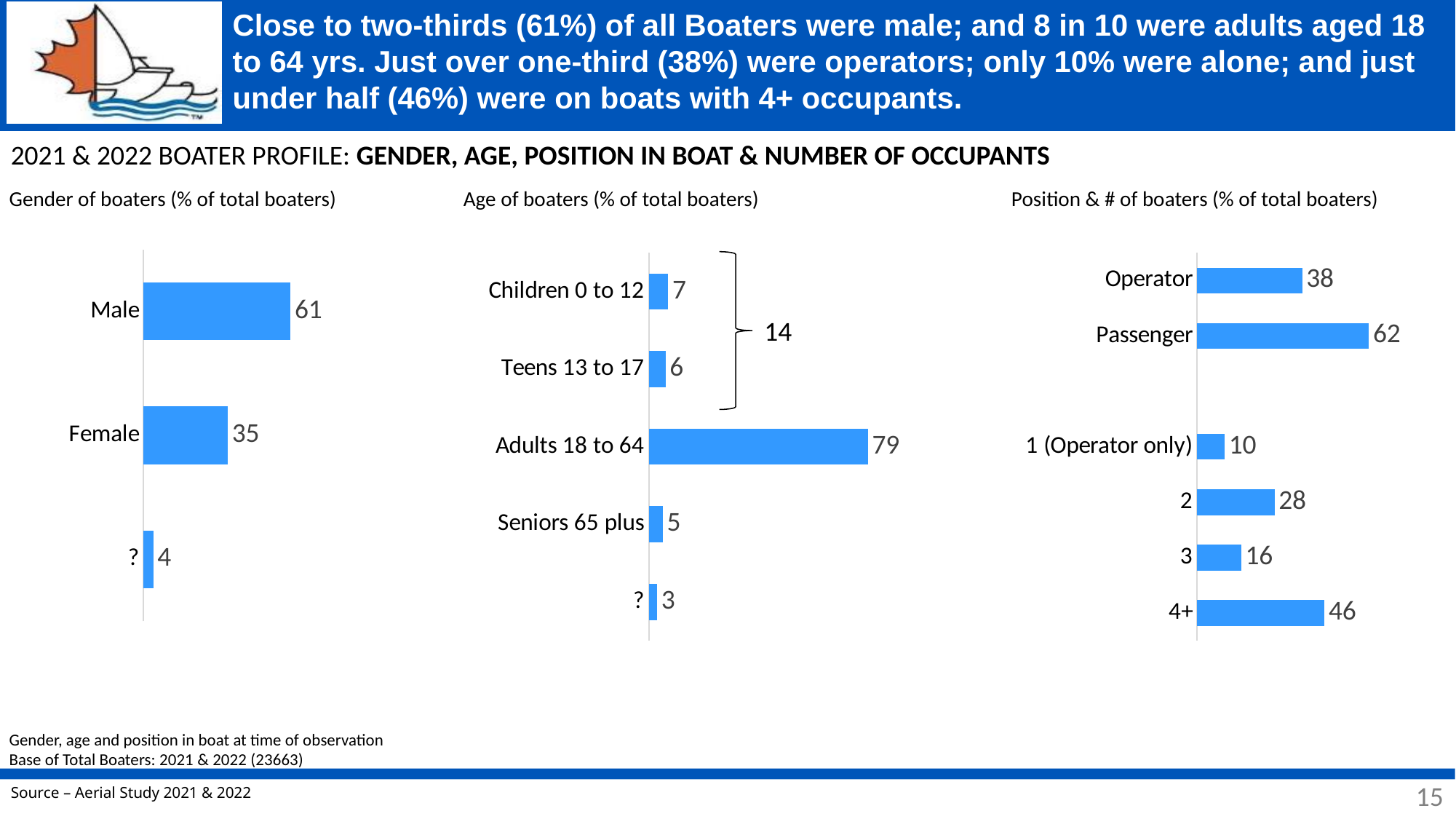
In the 'Gender of boaters' chart, what is the difference between the Male and Female values? 26 What type of chart is the 'Gender of boaters' chart? Bar chart In the 'Age of boaters' chart, which is larger, Children 0 to 12 or Seniors 65 plus? Children 0 to 12 In the 'Gender of boaters' chart, what is the value for Female? 35 In the 'Age of boaters' chart, how many categories are plotted? 5 In the 'Position & # of boaters' chart, which category has the highest value? Passenger In the 'Gender of boaters' chart, what is the value for Male? 61 In the 'Position & # of boaters' chart, what is the value for 4+? 46 In the 'Age of boaters' chart, what is the value for Adults 18 to 64? 79 In the 'Position & # of boaters' chart, what is the value for Passenger? 62 In the 'Age of boaters' chart, which category has the lowest value? ? In the 'Position & # of boaters' chart, what is the difference between the values for 2 and 3 occupants? 12